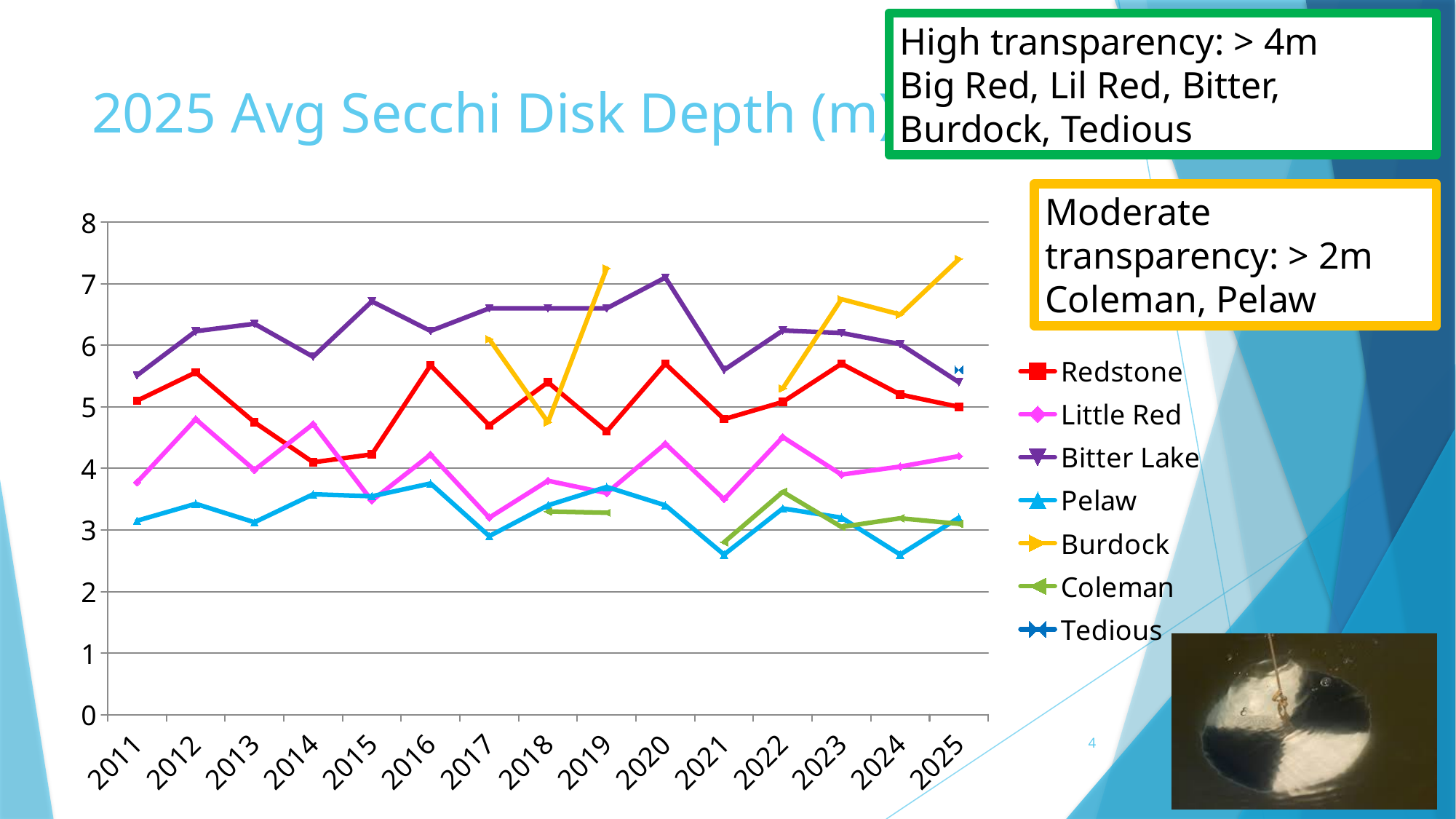
Is the value for Redstone in 2016 greater or less than 5? greater Is the value for Pelaw in 2021 greater or less than 3? less Which lake has the lowest Secchi disk depth in 2024? Pelaw What kind of chart is shown on the slide? line chart Which is higher in 2019, Bitter Lake or Burdock? Burdock Which lake has the highest Secchi disk depth in 2025? Burdock Which is higher in 2016, Redstone or Little Red? Redstone Does the Burdock line rise or fall from 2022 to 2025? rise How many series does the legend list? 7 How many years are shown along the x axis? 15 What is the title of the chart? 2025 Avg Secchi Disk Depth (m) Is the value for Burdock in 2025 greater or less than 7? greater